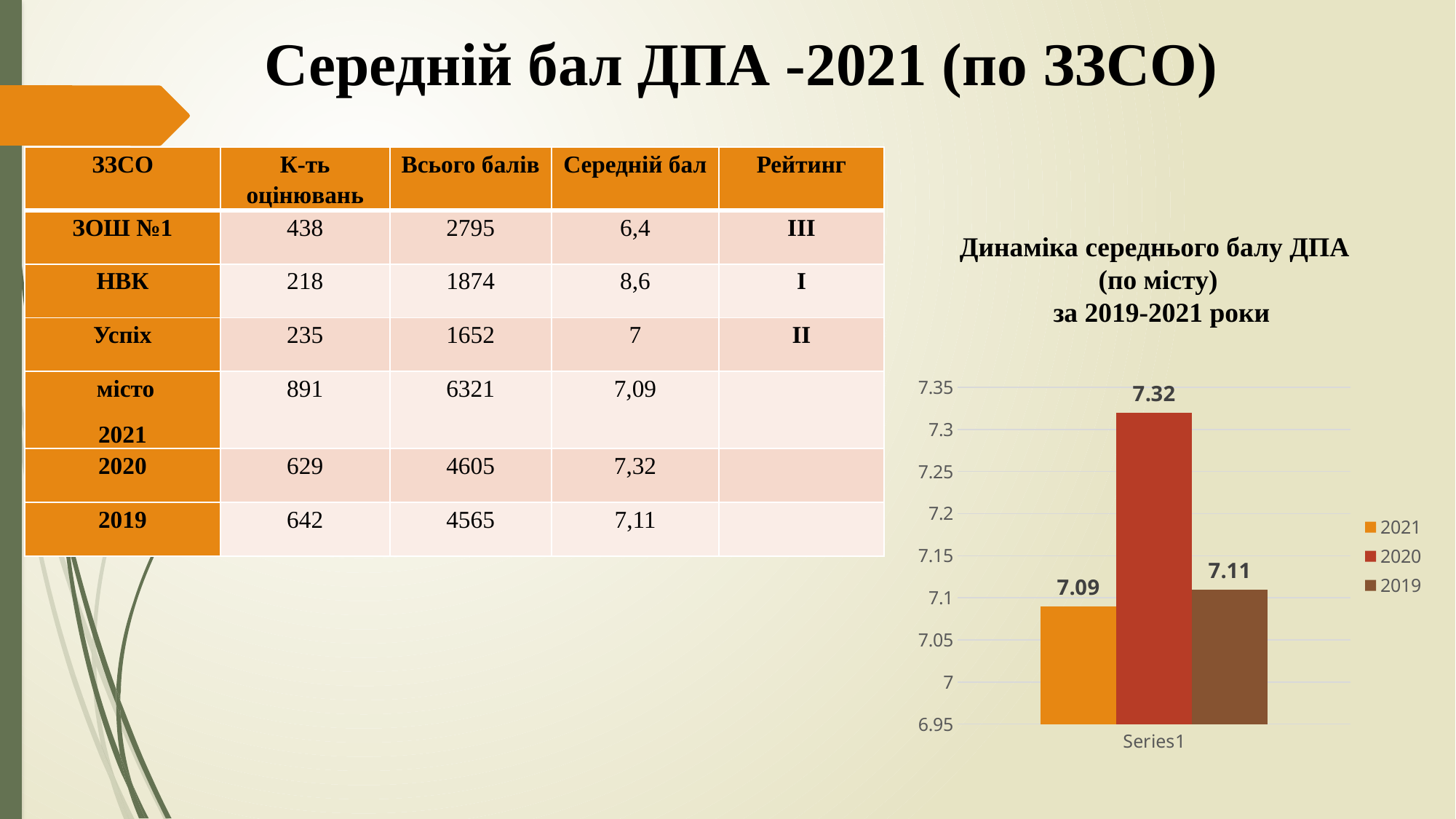
What is the difference between the 2019 and 2021 values in the chart? 0.02 What is the value of the 2020 bar in the chart? 7.32 What is the difference between the 2020 and 2021 values in the chart? 0.23 Which year has the lowest bar in the chart? 2021 What is the value of the 2021 bar in the chart? 7.09 How many series does the chart legend list? 3 Which is larger in the chart, the 2020 value or the 2019 value? 2020 What kind of chart is shown on the slide? bar chart Is the value for 2020 in the chart greater or less than 7.2? greater What is the category label shown on the x axis of the chart? Series1 What is the value of the 2019 bar in the chart? 7.11 Which year has the highest bar in the chart? 2020